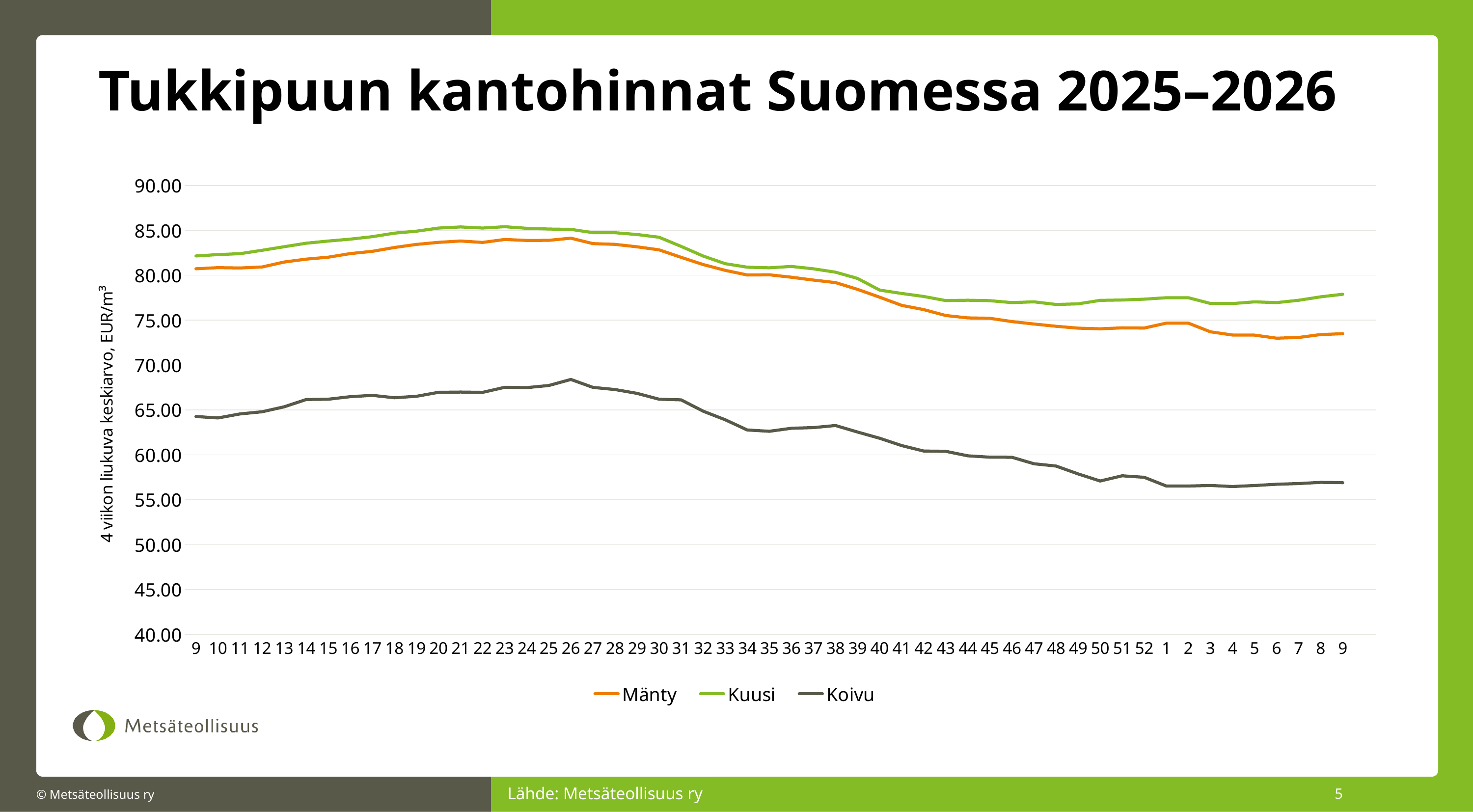
Which series has the lowest values across the whole chart? Koivu Does the Koivu line rise or fall from week 26 to week 1? fall Is the value for Kuusi at week 40 greater or less than 80.00? less Which series has the highest value at week 20? Kuusi How many series does the legend list? 3 Which series is plotted with the orange line? Mänty Is the value for Koivu at week 26 greater or less than 65.00? greater What is the y-axis label of the chart? 4 viikon liukuva keskiarvo, EUR/m³ At week 30, which is larger, the value for Kuusi or the value for Mänty? Kuusi What kind of chart is shown on the slide? line chart Is the value for Koivu at week 1 greater or less than 60.00? less